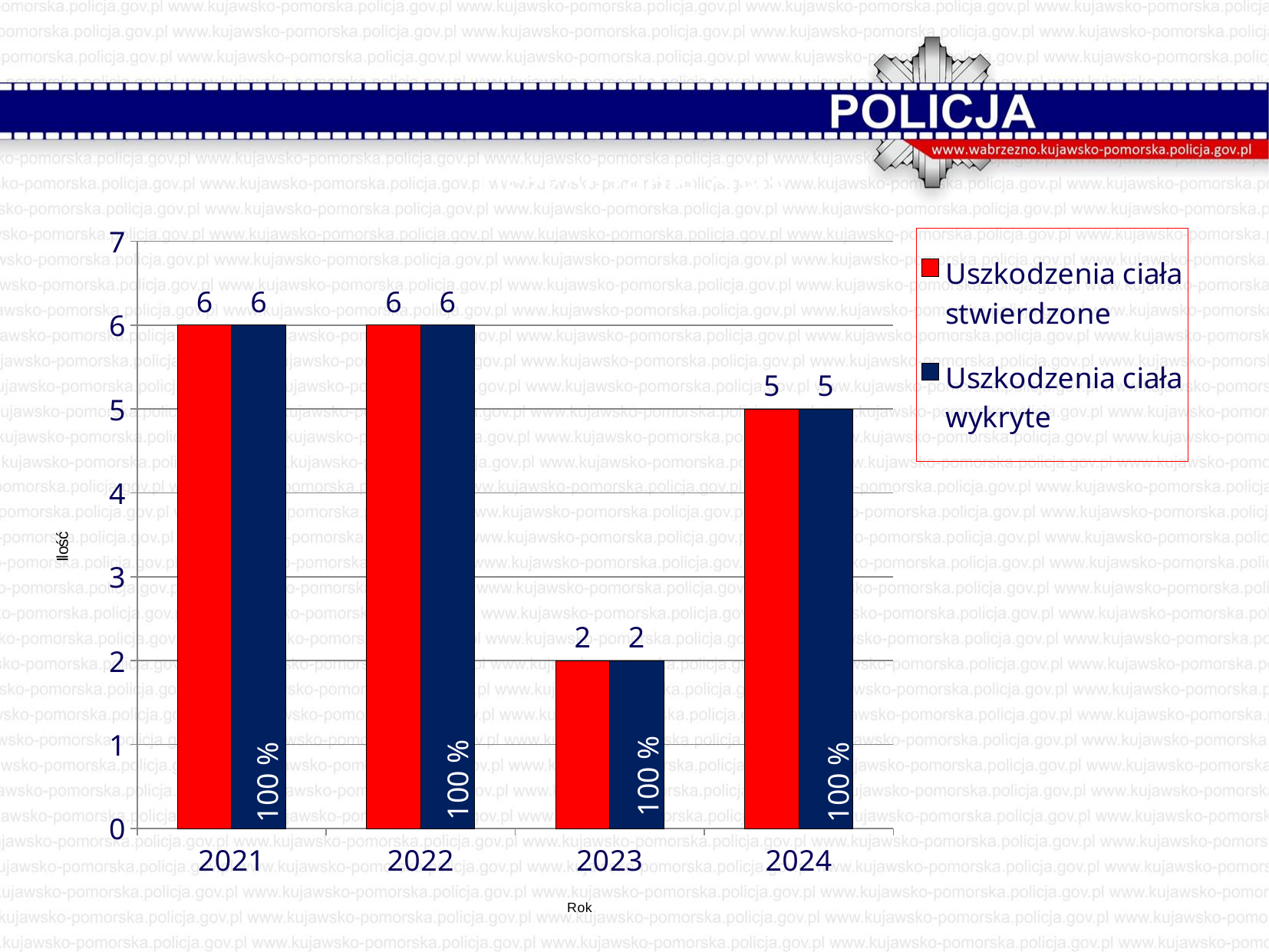
What percentage label is printed on the 'Uszkodzenia ciała wykryte' bar for 2022? 100 % How many years are shown on the x axis? 4 What kind of chart is shown on the slide? bar chart What is the label of the y axis? Ilość Is the value for 'Uszkodzenia ciała wykryte' in 2024 larger or smaller than in 2023? larger How many series does the legend list? 2 What is the value of 'Uszkodzenia ciała stwierdzone' for 2021? 6 What is the value of 'Uszkodzenia ciała stwierdzone' for 2023? 2 What is the difference between the 'Uszkodzenia ciała stwierdzone' values for 2022 and 2023? 4 Does the value for 'Uszkodzenia ciała stwierdzone' rise or fall from 2023 to 2024? rise What is the value of 'Uszkodzenia ciała wykryte' for 2024? 5 Which year has the lowest value for 'Uszkodzenia ciała stwierdzone'? 2023